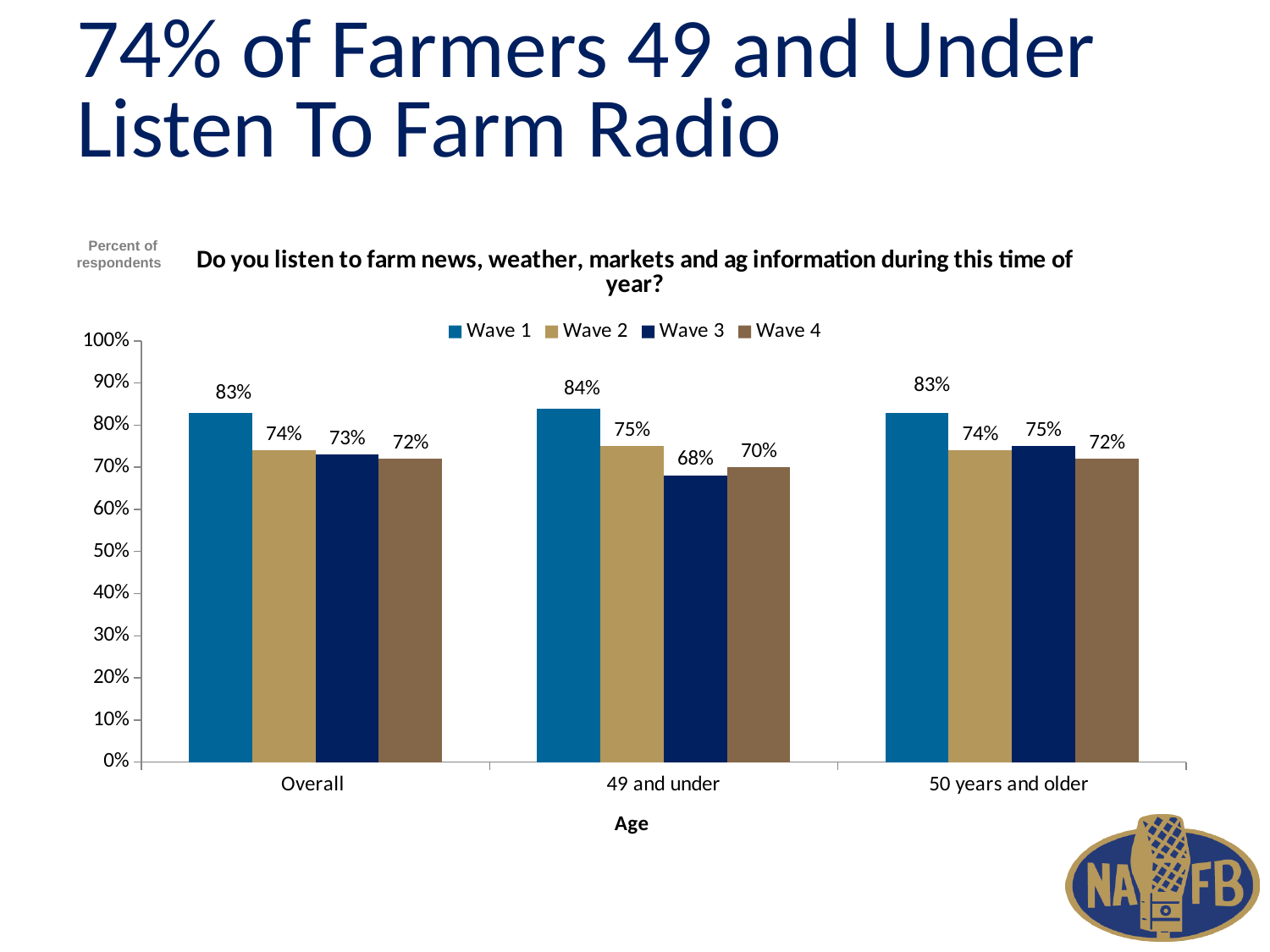
How many series does the legend list? 4 Which wave has the highest value in the 49 and under category? Wave 1 What is the Wave 4 value for the 50 years and older category? 72% What kind of chart is shown on the slide? Bar chart What is the Wave 3 value for the 49 and under category? 68% How many age categories are shown on the x axis? 3 What is the Wave 1 value for the Overall category? 83% What is the label of the x axis? Age Which wave has the lowest value in the 49 and under category? Wave 3 Which is larger: the Wave 3 value for Overall or the Wave 3 value for 49 and under? Overall What is the Wave 2 value for the 49 and under category? 75% What is the difference between the Wave 1 and Wave 3 values for the 49 and under category? 16%